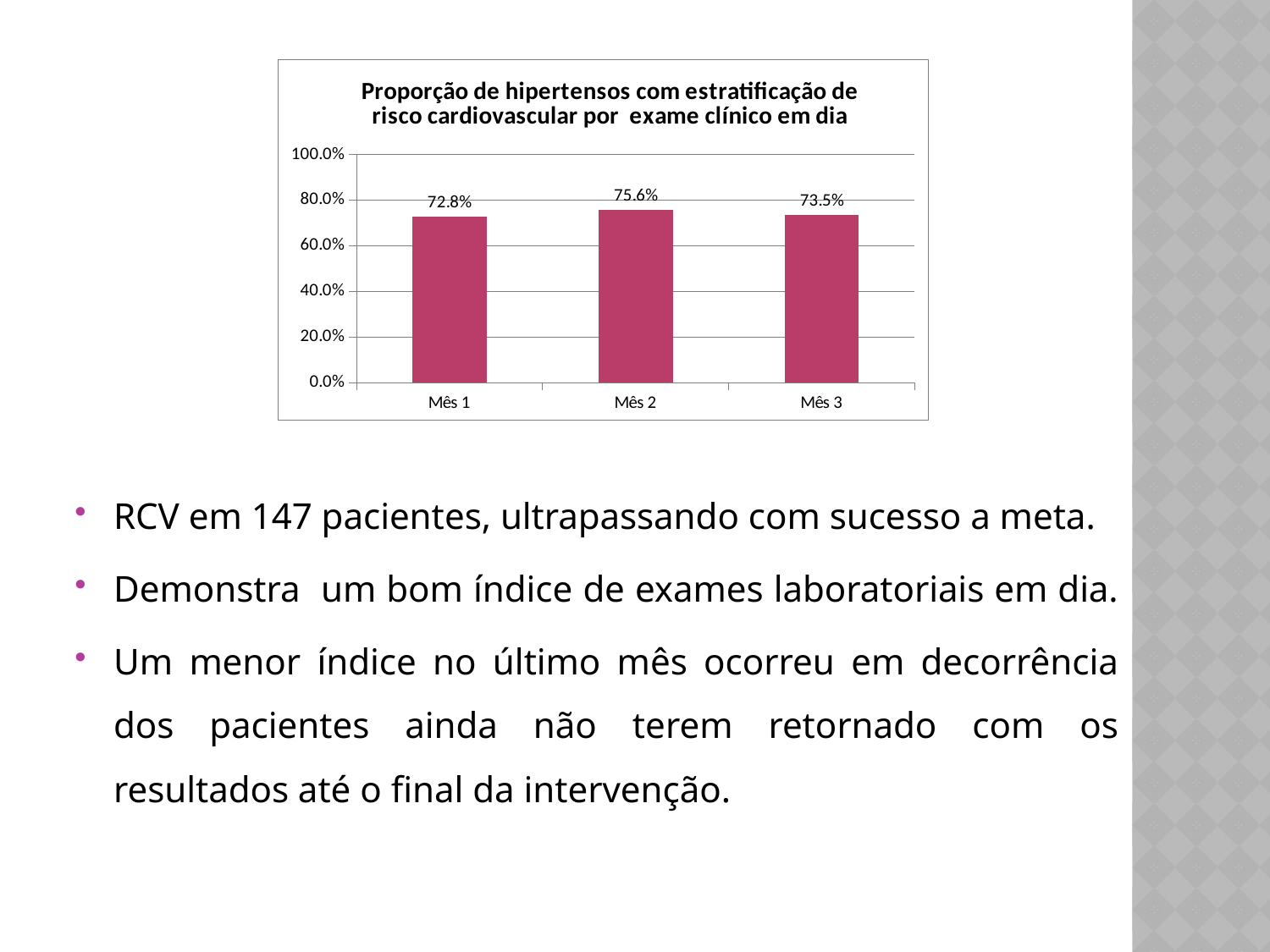
What is the value for Mês 2? 75.6% Which month has the lowest value? Mês 1 What is the title of the chart? Proporção de hipertensos com estratificação de risco cardiovascular por exame clínico em dia Which month has the highest value? Mês 2 What is the value for Mês 1? 72.8% What kind of chart is shown on the slide? bar chart What is the value for Mês 3? 73.5% How many months are shown on the chart? 3 Is the value for Mês 2 greater or less than 80.0%? less Which is larger, the value for Mês 1 or the value for Mês 3? Mês 3 What is the difference between the values for Mês 2 and Mês 3? 2.1% What is the difference between the values for Mês 2 and Mês 1? 2.8%